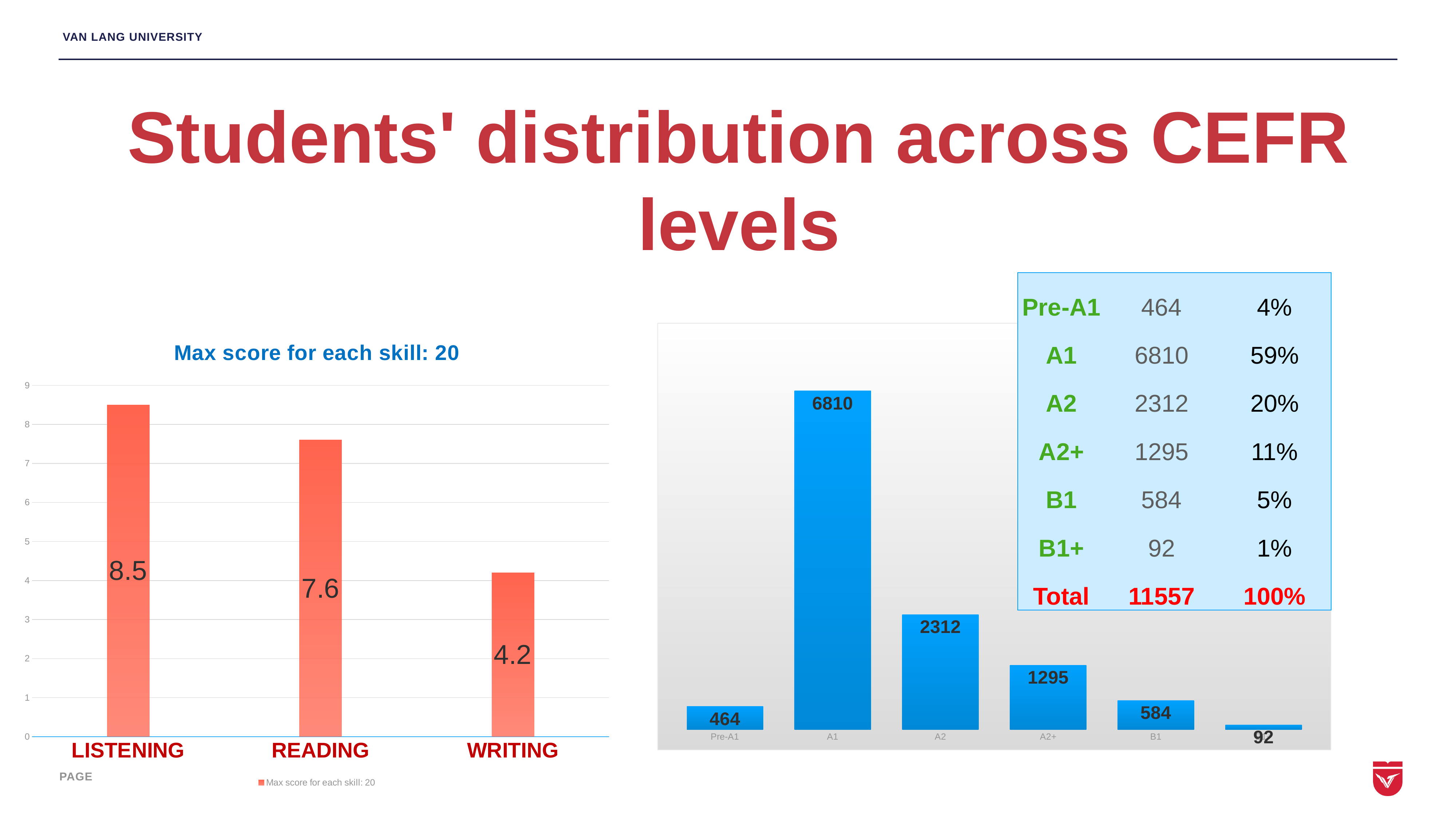
What type of chart is the right chart of students across CEFR levels? bar chart In the right chart of students across CEFR levels, what is the difference between the A1 and A2 values? 4498 In the right chart of students across CEFR levels, which is larger, the value for Pre-A1 or the value for B1? B1 In the left chart titled 'Max score for each skill: 20', how many skills are plotted? 3 In the left chart titled 'Max score for each skill: 20', which skill has the lowest score? WRITING In the right chart of students across CEFR levels, which level has the highest number of students? A1 In the right chart of students across CEFR levels, which level has the lowest number of students? B1+ In the left chart titled 'Max score for each skill: 20', what is the value for LISTENING? 8.5 In the left chart titled 'Max score for each skill: 20', do the values rise or fall from LISTENING to WRITING? fall In the right chart of students across CEFR levels, what is the value for A2? 2312 In the left chart titled 'Max score for each skill: 20', what is the difference between the LISTENING and READING scores? 0.9 In the left chart titled 'Max score for each skill: 20', what is the value for WRITING? 4.2